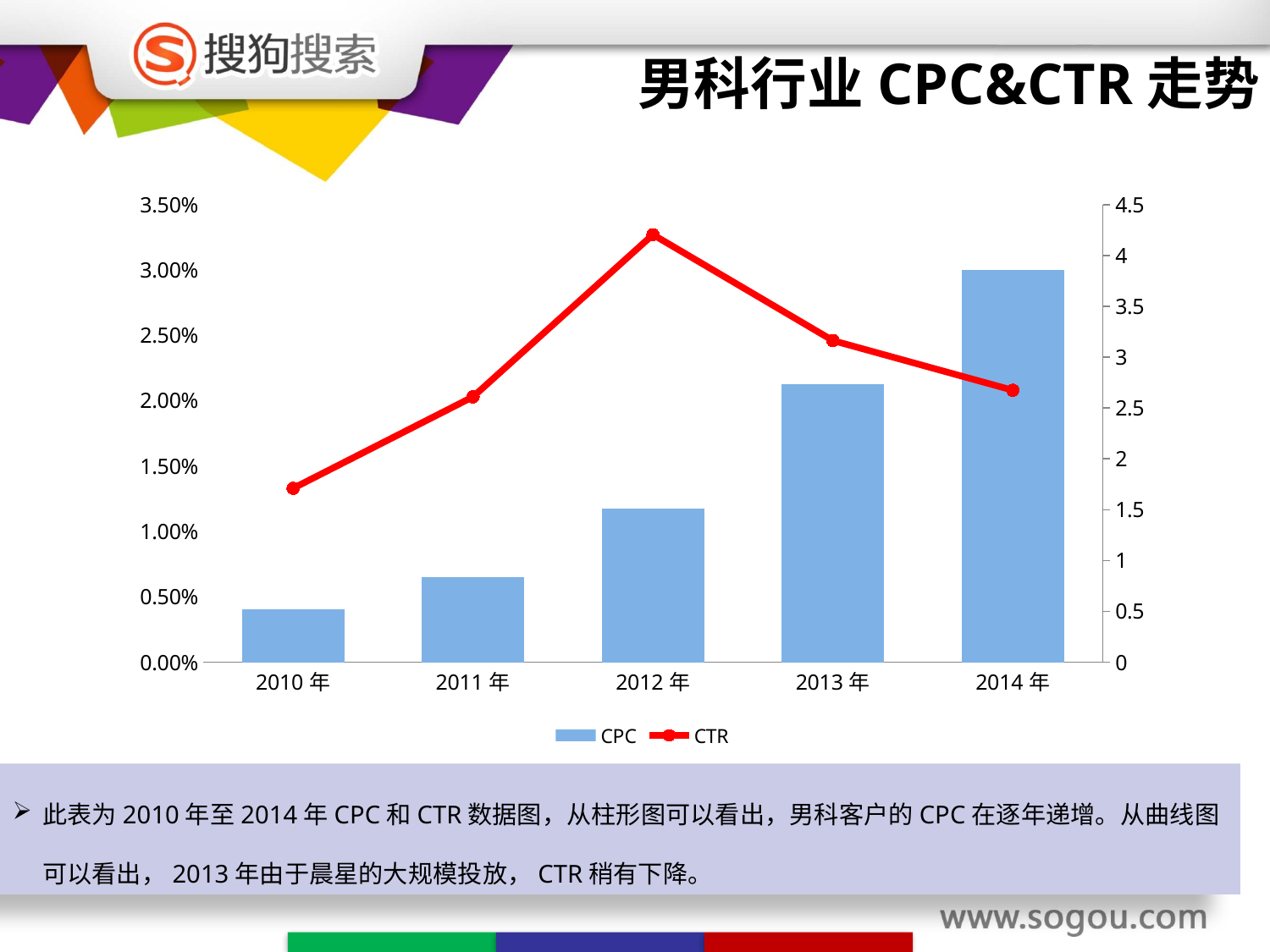
Is the CTR value for 2012 greater or less than 3.00% on the left axis? greater What is the title of the chart slide? 男科行业CPC&CTR走势 How many years are shown on the x axis of the chart? 5 In which year does the CTR line reach its peak? 2012年 Which year has the highest CPC bar? 2014年 Which year has the higher CTR value, 2011 or 2013? 2013年 Is the CPC value for 2014 greater or less than 3.5 on the right axis? greater How many series does the chart legend list? 2 Which year has the lowest CPC bar? 2010年 Do the CPC bars rise or fall from 2010 to 2014? Rise What kind of chart is shown on the slide? A combination bar and line chart In which year is the CTR value lowest? 2010年